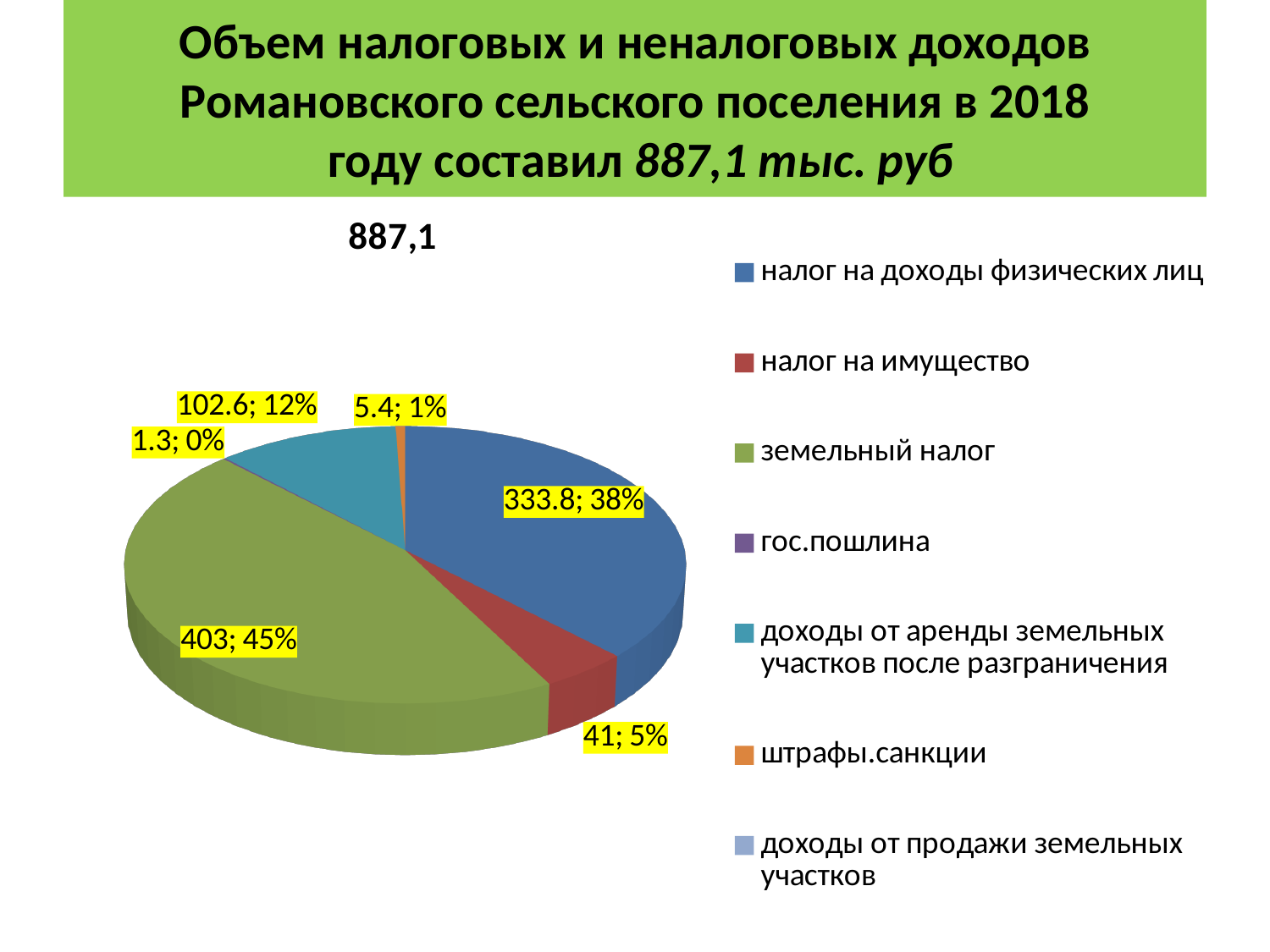
What share of the pie does налог на доходы физических лиц represent? 38% What share of the pie does земельный налог represent? 45% What kind of chart is shown on the slide? pie chart What is the value shown for налог на доходы физических лиц? 333.8 Which category has the largest slice of the pie? земельный налог What is the value shown for доходы от аренды земельных участков после разграничения? 102.6 What is the value shown for налог на имущество? 41 How many categories does the legend list? 7 Which is larger: налог на доходы физических лиц or доходы от аренды земельных участков после разграничения? налог на доходы физических лиц What is the difference between the values for земельный налог and налог на доходы физических лиц? 69.2 What is the value shown for земельный налог? 403 What is the value shown for штрафы.санкции? 5.4